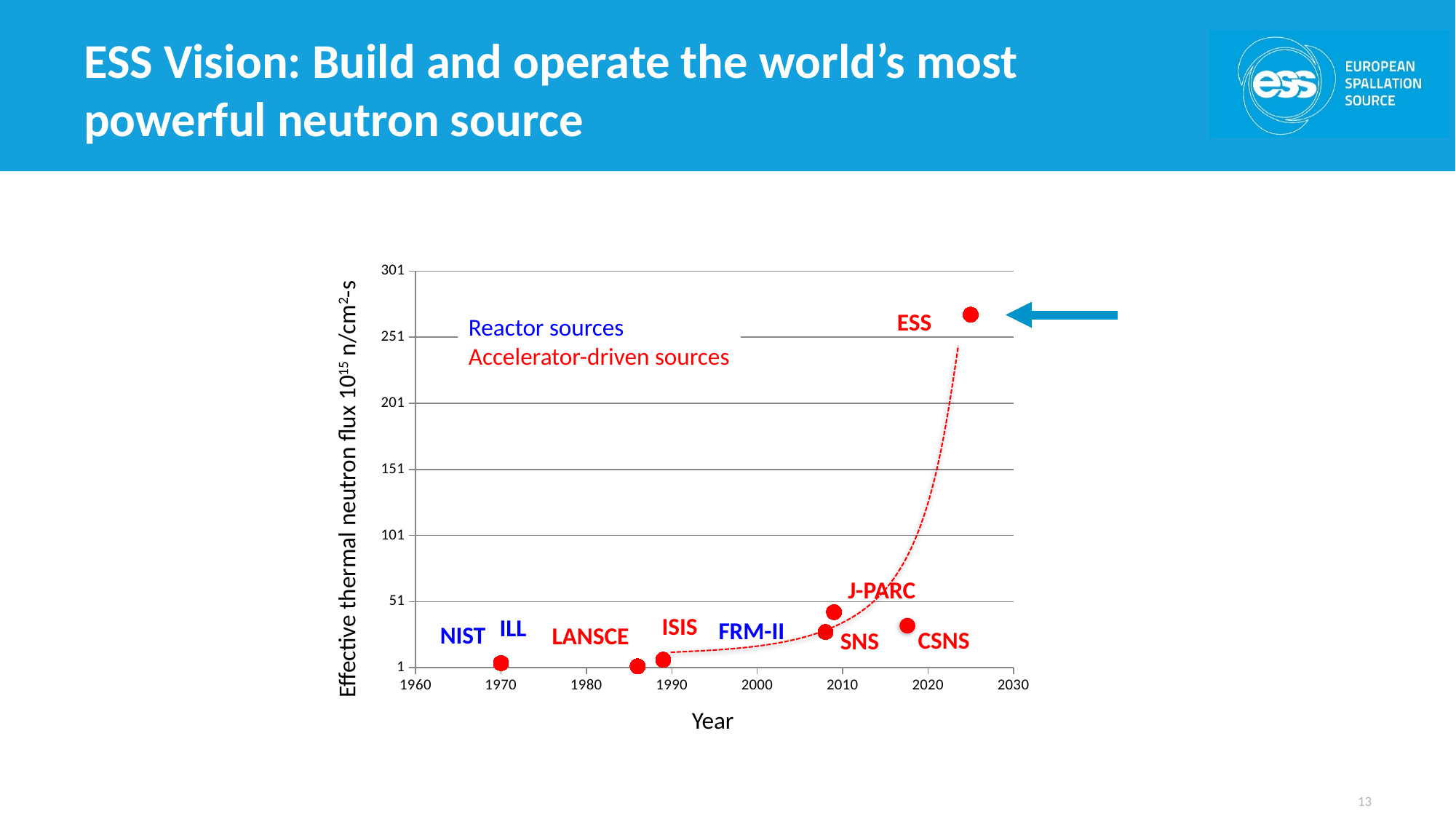
Which has the higher effective thermal neutron flux, J-PARC or CSNS? J-PARC Which sources are labelled in blue as reactor sources? NIST, ILL, FRM-II Which neutron source has the highest effective thermal neutron flux on the chart? ESS What is the label of the x axis? Year Which has the higher effective thermal neutron flux, ESS or J-PARC? ESS How many neutron sources are labelled on the chart? 9 What kind of chart is shown on the slide? Scatter chart Do the effective thermal neutron flux values generally rise or fall as the year increases? rise Is the value for J-PARC greater or less than 51? less Is the value for ESS greater or less than 251? greater Is the value for CSNS greater or less than 101? less